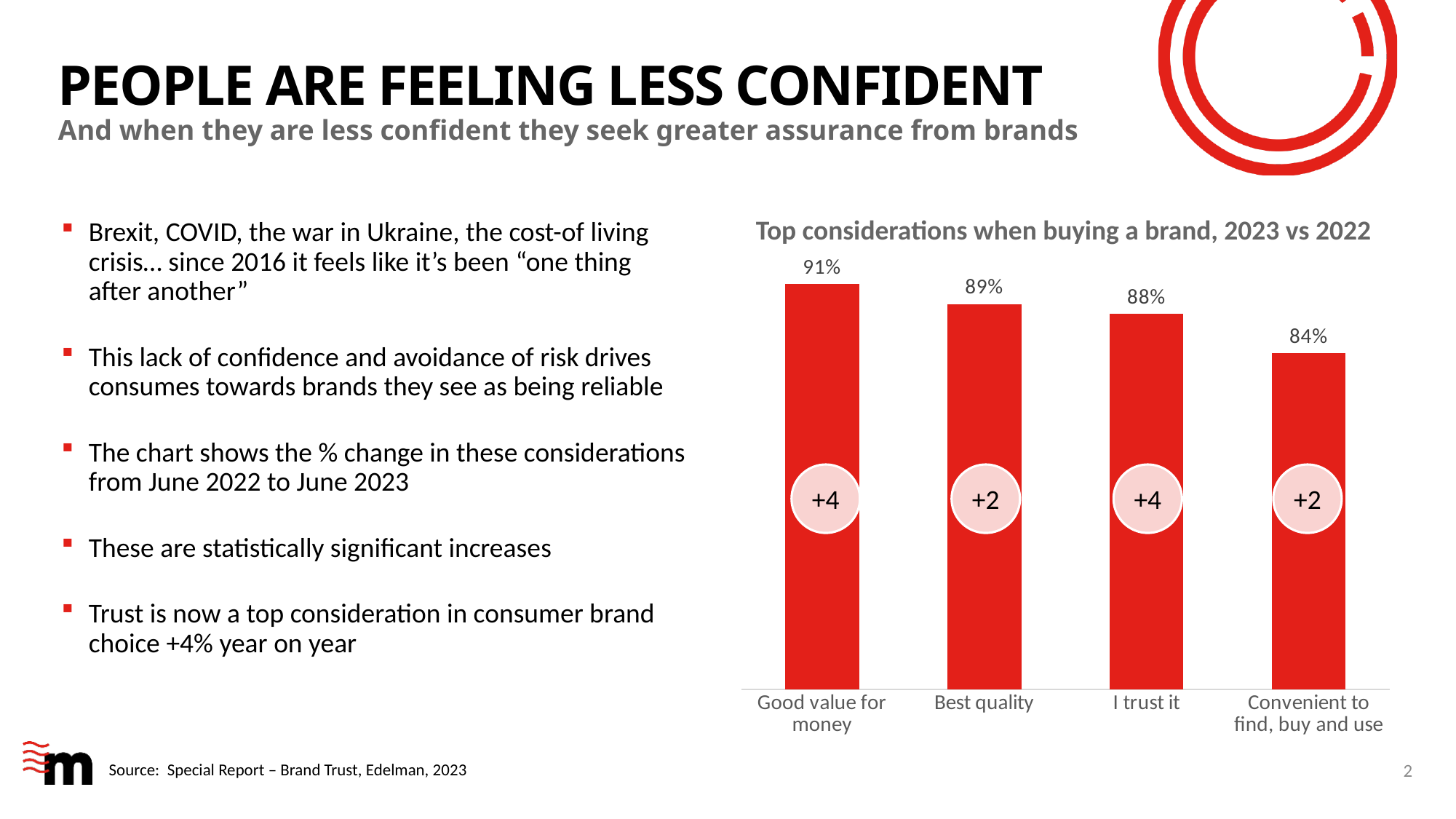
Which category has the lowest value? Convenient to find, buy and use What is the value for Convenient to find, buy and use? 84% What is the value for Best quality? 89% Which category has the highest value? Good value for money What is the year-on-year change shown in the circle on the I trust it bar? +4 What is the value for Good value for money? 91% How many categories are shown in the chart? 4 What is the title of the chart? Top considerations when buying a brand, 2023 vs 2022 What is the difference between the values for Good value for money and Convenient to find, buy and use? 7 percentage points What kind of chart is shown on the slide? Bar chart Which is larger, the value for Best quality or the value for I trust it? Best quality What is the value for I trust it? 88%